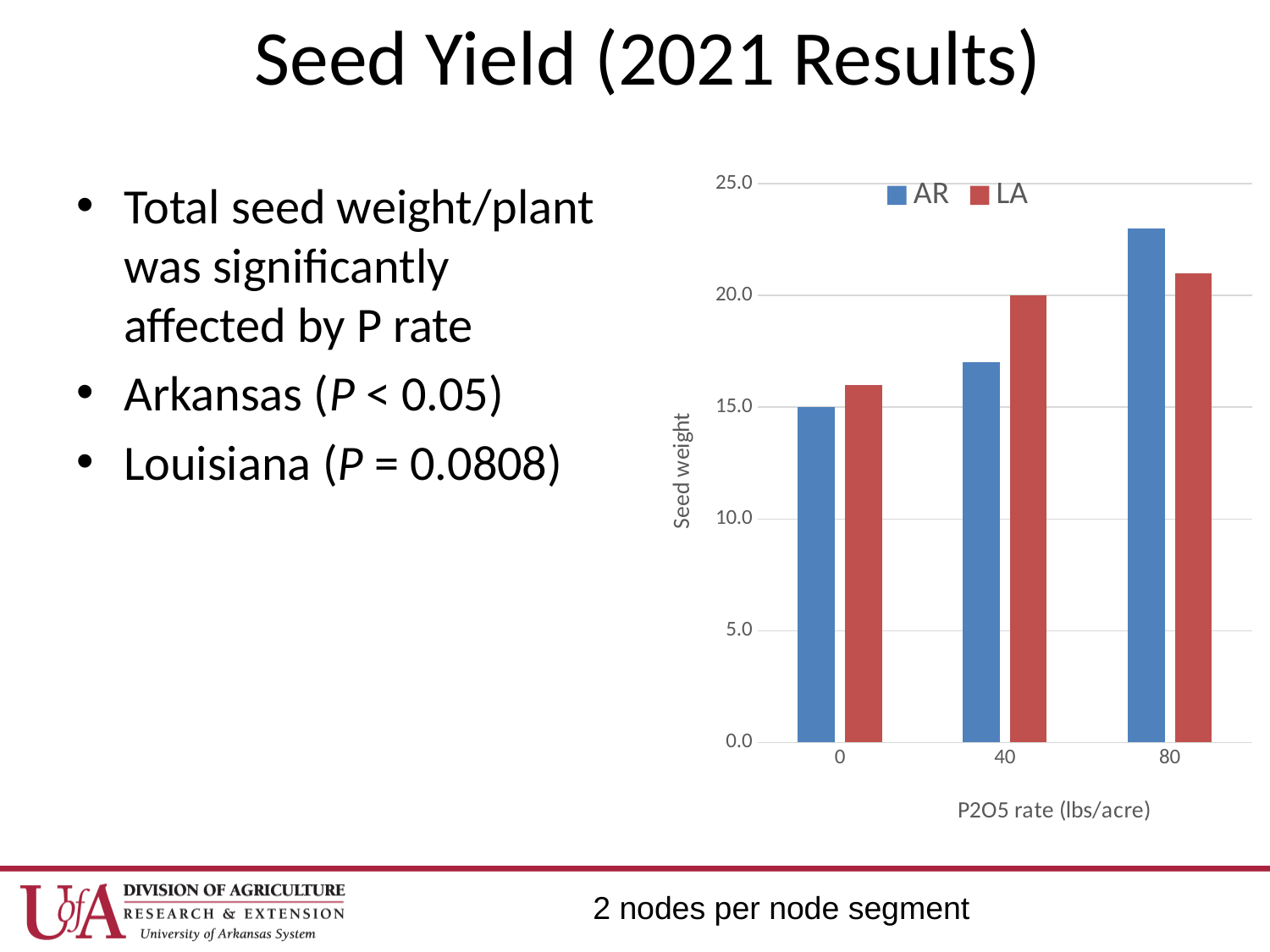
Is the value for AR at a P2O5 rate of 80 greater or less than 20? greater How many series does the chart legend list? 2 Do the AR seed weight values rise or fall as the P2O5 rate increases from 0 to 80? rise What is the seed weight for LA at a P2O5 rate of 40? 20.0 Is the value for AR at a P2O5 rate of 40 greater or less than 20? less At which P2O5 rate is the AR seed weight highest? 80 What kind of chart is shown on the slide? bar chart Is the value for LA at a P2O5 rate of 0 greater or less than 15? greater At a P2O5 rate of 80, which series has the larger seed weight, AR or LA? AR How many P2O5 rate categories are shown on the x axis? 3 What is the seed weight for AR at a P2O5 rate of 0? 15.0 What is the label on the x axis of the chart? P2O5 rate (lbs/acre)